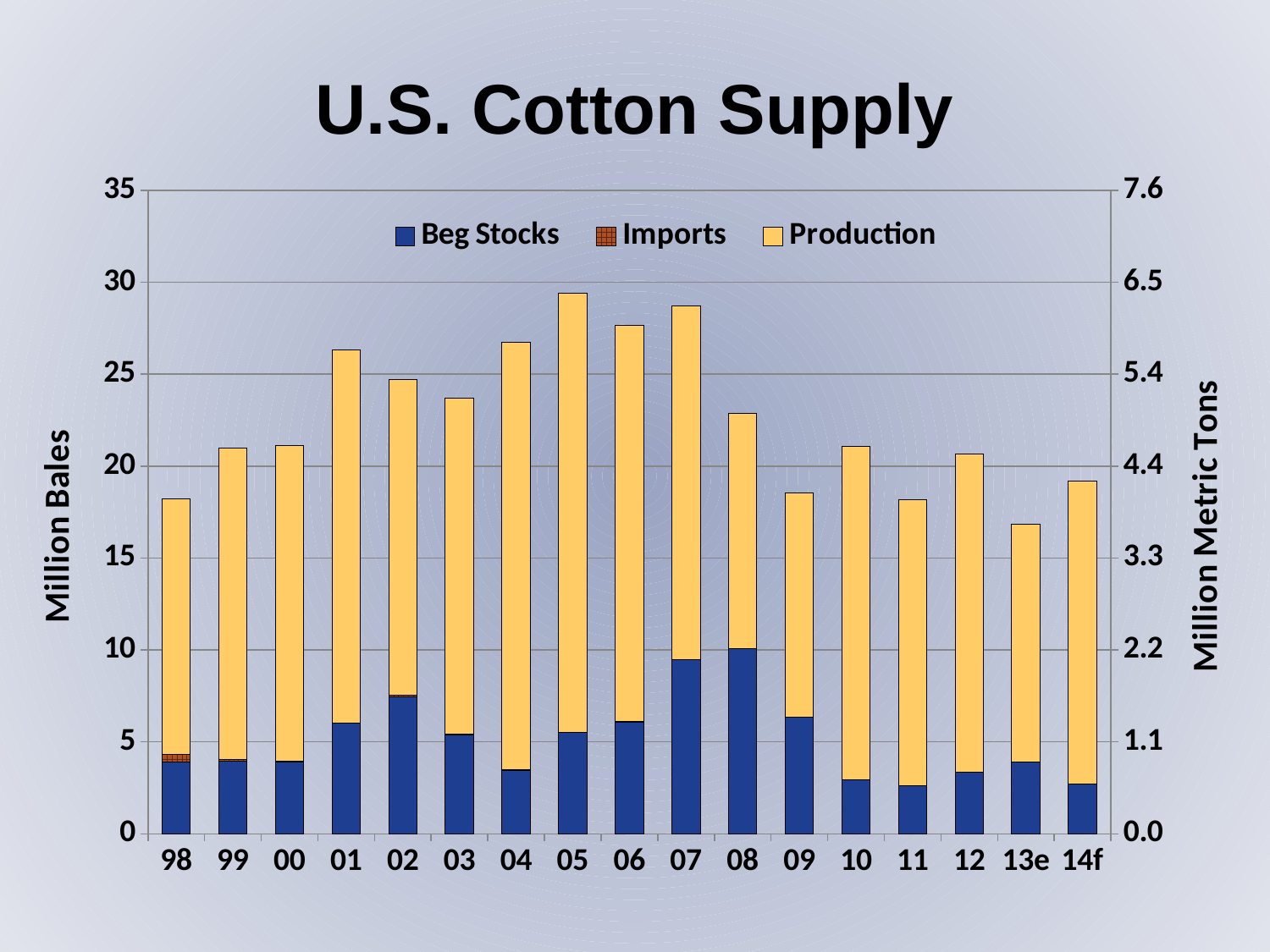
Which year has the larger Beg Stocks segment, 02 or 03? 02 Which year has the largest Beg Stocks segment? 08 What kind of chart is shown on the slide? Stacked bar chart Is the total supply bar for 13e greater or less than 20 million bales? less Is the Beg Stocks segment for 07 greater or less than 5 million bales? greater What is the label on the left vertical axis? Million Bales How many series does the legend list? 3 Which year has the taller total supply bar, 10 or 11? 10 Which year has the highest total supply bar? 05 Which year has the lowest total supply bar? 13e Is the total supply bar for 05 greater or less than 25 million bales? greater How many years (categories) are shown on the x axis? 17